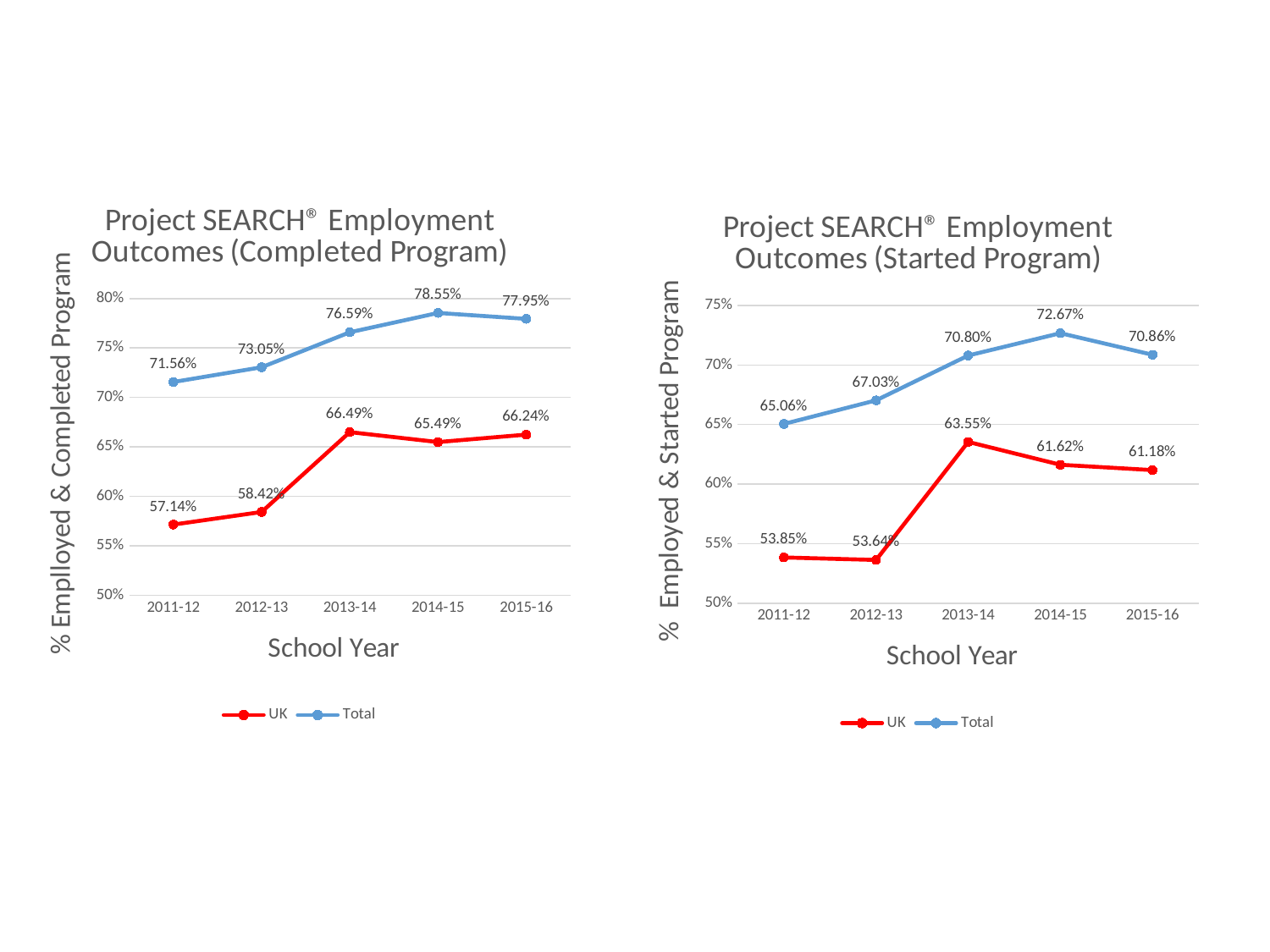
How many school years are plotted on the x axis of the 'Completed Program' chart on the left? 5 In the 'Started Program' chart on the right, what is the Total value for 2015-16? 70.86% In the 'Completed Program' chart on the left, which school year has the highest Total value? 2014-15 In the 'Started Program' chart on the right, what is the difference between the UK values for 2013-14 and 2012-13? 9.91% In the 'Completed Program' chart on the left, what is the difference between the Total and UK values for 2013-14? 10.10% In the 'Started Program' chart on the right, which school year has the lowest UK value? 2012-13 What type of chart is the 'Completed Program' chart on the left? Line chart In the 'Started Program' chart on the right, which is larger: the Total value for 2012-13 or the Total value for 2011-12? 2012-13 How many series does the legend of the 'Started Program' chart on the right list? 2 In the 'Started Program' chart on the right, what is the UK value for 2013-14? 63.55% In the 'Completed Program' chart on the left, what is the UK value for 2011-12? 57.14% In the 'Completed Program' chart on the left, what is the Total value for 2014-15? 78.55%